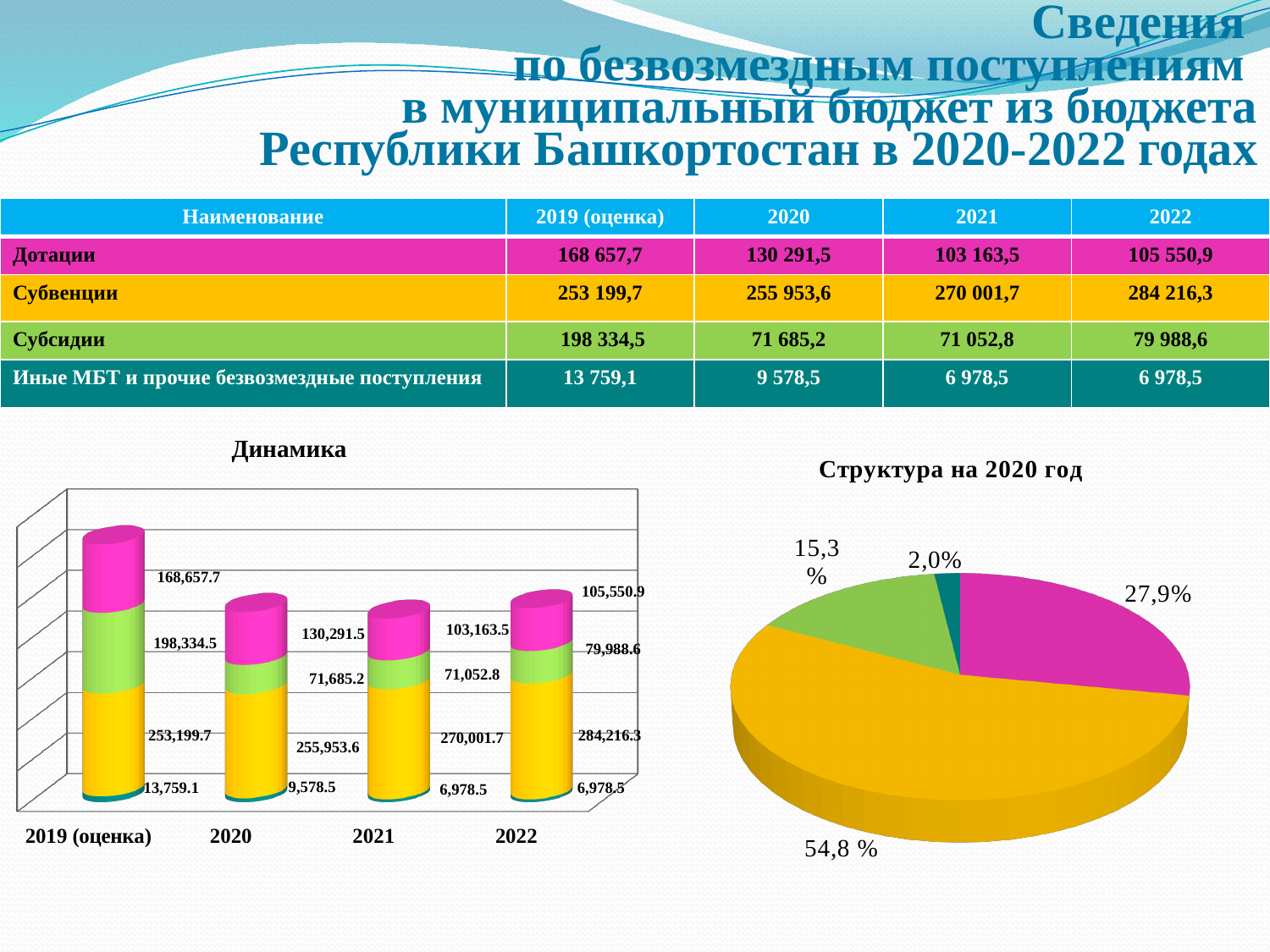
In the "Структура на 2020 год" pie chart, what is the share of the largest slice? 54,8 % In the "Динамика" chart, what is the value labelled on the pink (top) segment of the 2019 (оценка) bar? 168,657.7 In the "Динамика" chart, do the values of the yellow segment rise or fall from 2019 (оценка) to 2022? rise In the "Динамика" chart, what is the difference between the bottom (teal) segment values for 2020 and 2021? 2,600.0 In the "Структура на 2020 год" pie chart, what is the share of the smallest slice? 2,0% In the "Динамика" chart, how many years (categories) are shown on the x axis? 4 In the "Структура на 2020 год" pie chart, how many slices are there? 4 In the "Динамика" chart, what is the total of all four segments of the 2022 bar? 476,734.3 In the "Динамика" chart, is the pink segment larger in 2020 or in 2021? 2020 What kind of chart is the "Структура на 2020 год" chart on the right? pie chart What kind of chart is the "Динамика" chart on the left? bar chart In the "Динамика" chart, what is the value labelled on the yellow segment of the 2022 bar? 284,216.3